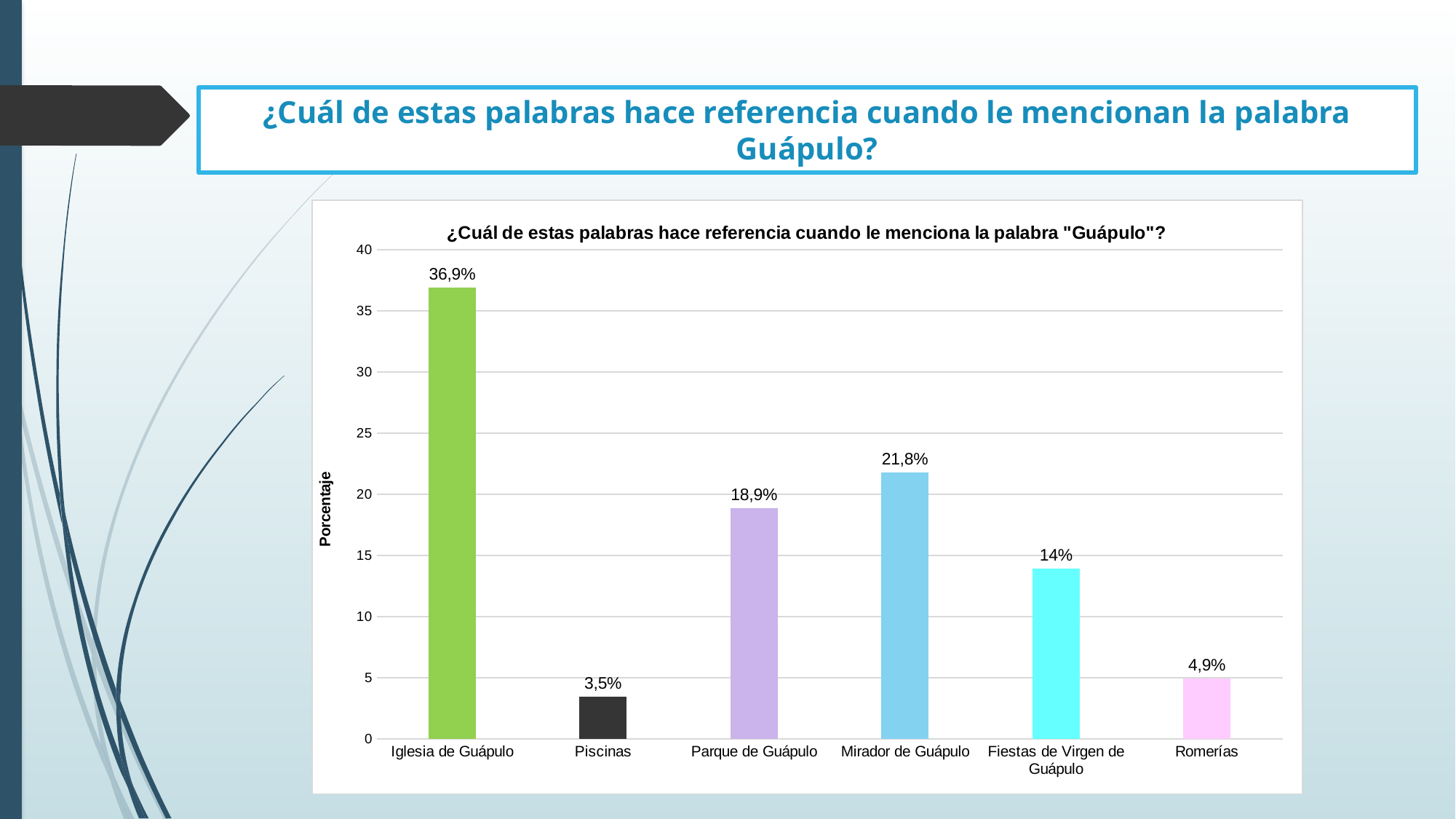
What kind of chart is shown on the slide? Bar chart Which is larger, the value for Parque de Guápulo or the value for Mirador de Guápulo? Mirador de Guápulo What is the value for Romerías? 4,9% Which category has the highest value? Iglesia de Guápulo What is the difference between the values for Parque de Guápulo and Fiestas de Virgen de Guápulo? 4,9% What is the value for Iglesia de Guápulo? 36,9% What is the value for Piscinas? 3,5% What is the difference between the values for Iglesia de Guápulo and Mirador de Guápulo? 15,1% Which category has the lowest value? Piscinas What is the label of the y axis? Porcentaje How many categories are shown on the x axis? 6 What is the value for Mirador de Guápulo? 21,8%